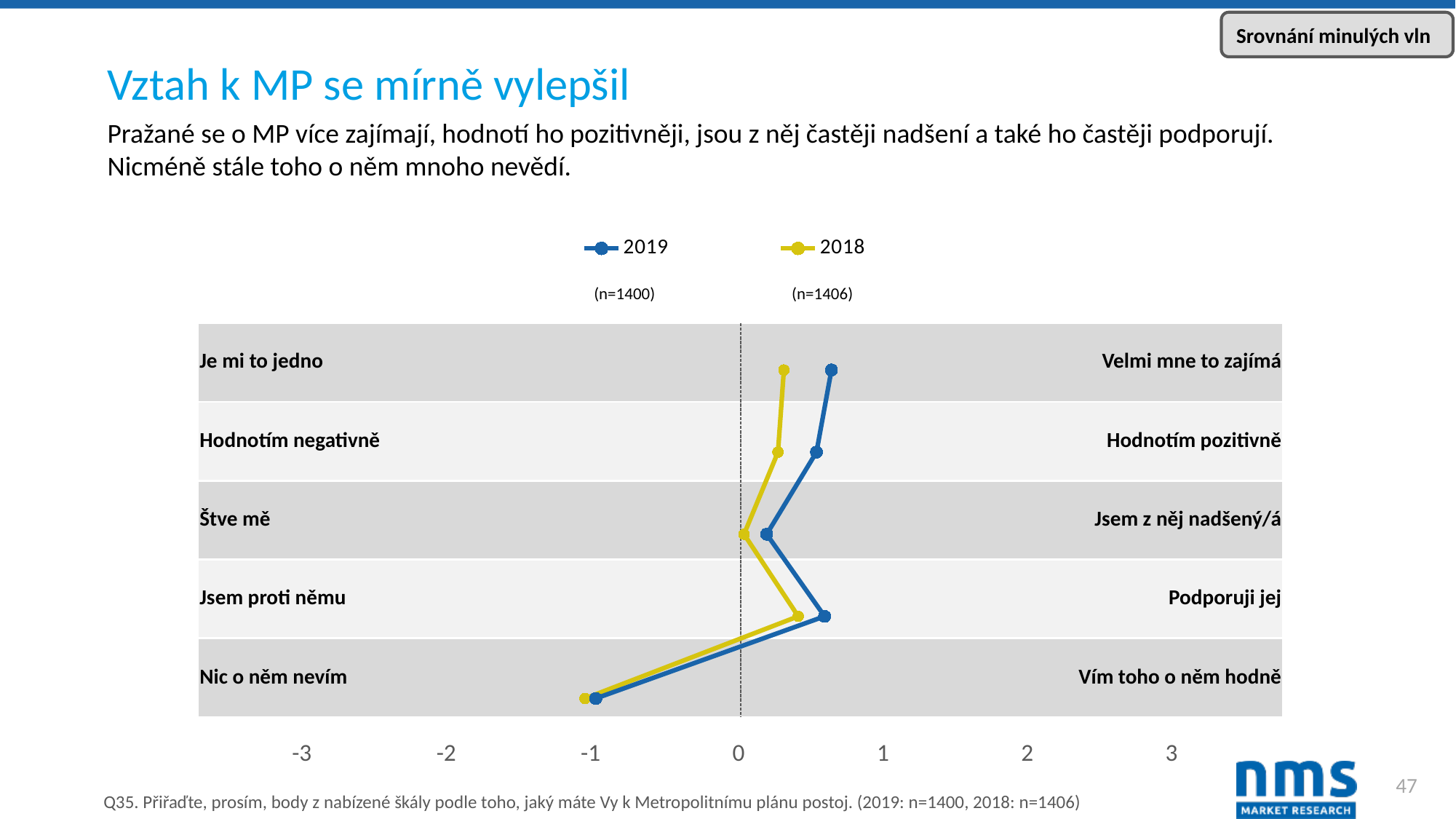
For the row 'Hodnotím negativně / Hodnotím pozitivně', which series has the larger value, 2019 or 2018? 2019 Is the 2019 value for 'Nic o něm nevím / Vím toho o něm hodně' greater or less than 0? less Which two years are compared in the chart legend? 2019 and 2018 For the row 'Je mi to jedno / Velmi mne to zajímá', which series has the larger value, 2019 or 2018? 2019 How many statement pairs (rows) are plotted in the chart? 5 Is the 2019 value for 'Je mi to jedno / Velmi mne to zajímá' greater or less than 0? greater What kind of chart is shown on the slide? line chart Which row has the lowest value for the 2019 series? Nic o něm nevím / Vím toho o něm hodně Which row has the lowest value for the 2018 series? Nic o něm nevím / Vím toho o něm hodně How many series does the chart legend list? 2 Is the 2018 value for 'Jsem proti němu / Podporuji jej' greater or less than 1? less What sample size (n) is shown for the 2019 series? n=1400